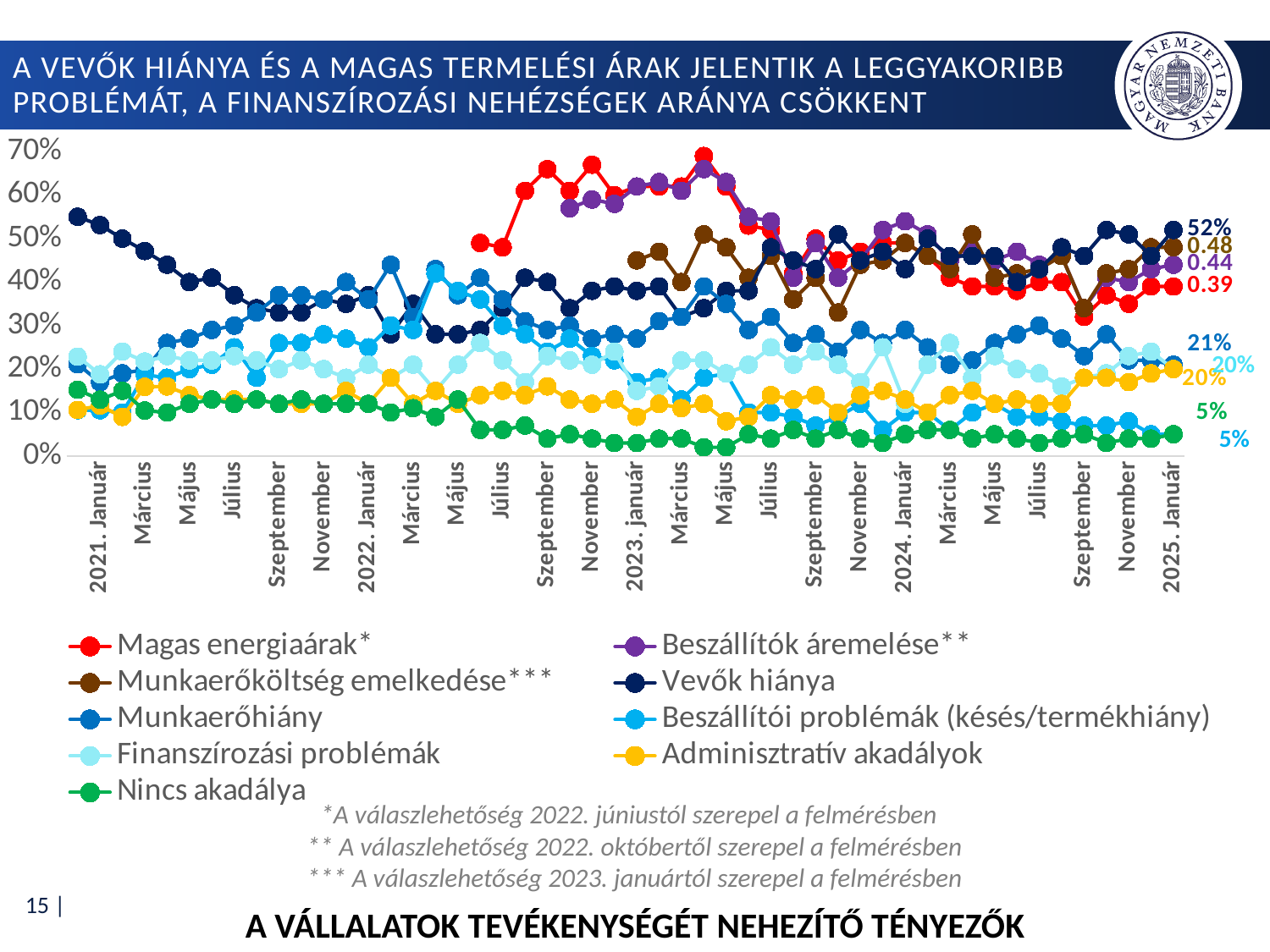
Which is larger at 2025. Január: Vevők hiánya or Munkaerőhiány? Vevők hiánya What is the value for Vevők hiánya at 2025. Január? 52% What kind of chart is shown on the slide? line chart What is the value for Munkaerőhiány at 2025. Január? 21% Which series has the highest value at 2025. Január? Vevők hiánya What is the value labelled for Beszállítók áremelése** at 2025. Január? 0.44 What is the value for Nincs akadálya at 2025. Január? 5% What is the value labelled for Magas energiaárak* at 2025. Január? 0.39 How many series does the legend list? 9 What is the value labelled for Munkaerőköltség emelkedése*** at the end of the series (2025. Január)? 0.48 According to the footnote, from which month has the Magas energiaárak answer option been included in the survey? 2022. június Is the value for Vevők hiánya at 2021. Január greater or less than 50%? greater